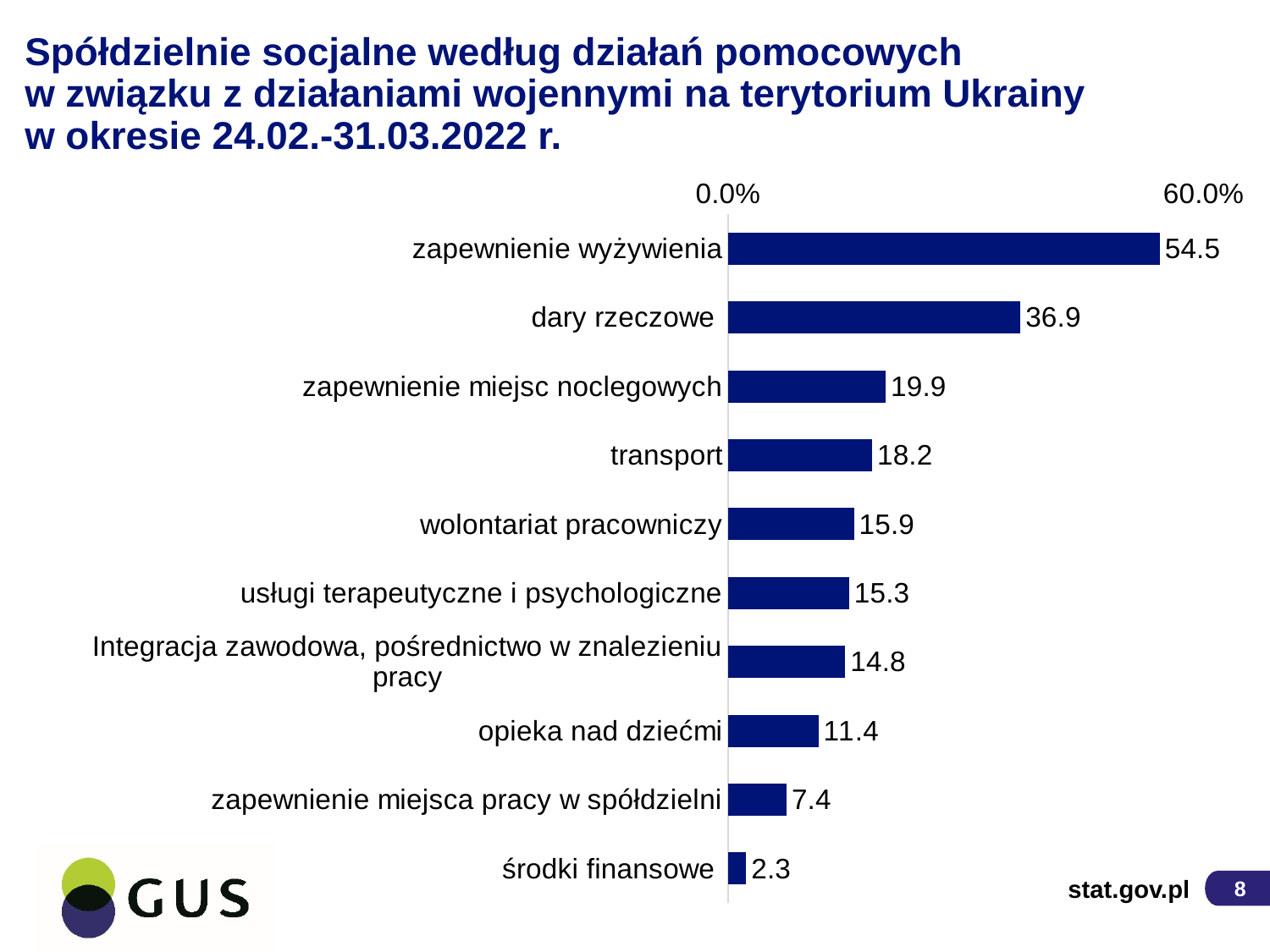
What is the maximum value shown on the chart's axis? 60.0% What is the value for "opieka nad dziećmi"? 11.4 What is the difference between the values for "zapewnienie wyżywienia" and "dary rzeczowe"? 17.6 How many categories are shown in the chart? 10 What is the value for "transport"? 18.2 Which category has the highest value? zapewnienie wyżywienia What is the value for "zapewnienie wyżywienia"? 54.5 What is the value for "zapewnienie miejsca pracy w spółdzielni"? 7.4 Which category has the lowest value? środki finansowe Which is larger, the value for "wolontariat pracowniczy" or the value for "opieka nad dziećmi"? wolontariat pracowniczy What kind of chart is shown on the slide? bar chart What is the difference between the values for "zapewnienie miejsc noclegowych" and "transport"? 1.7